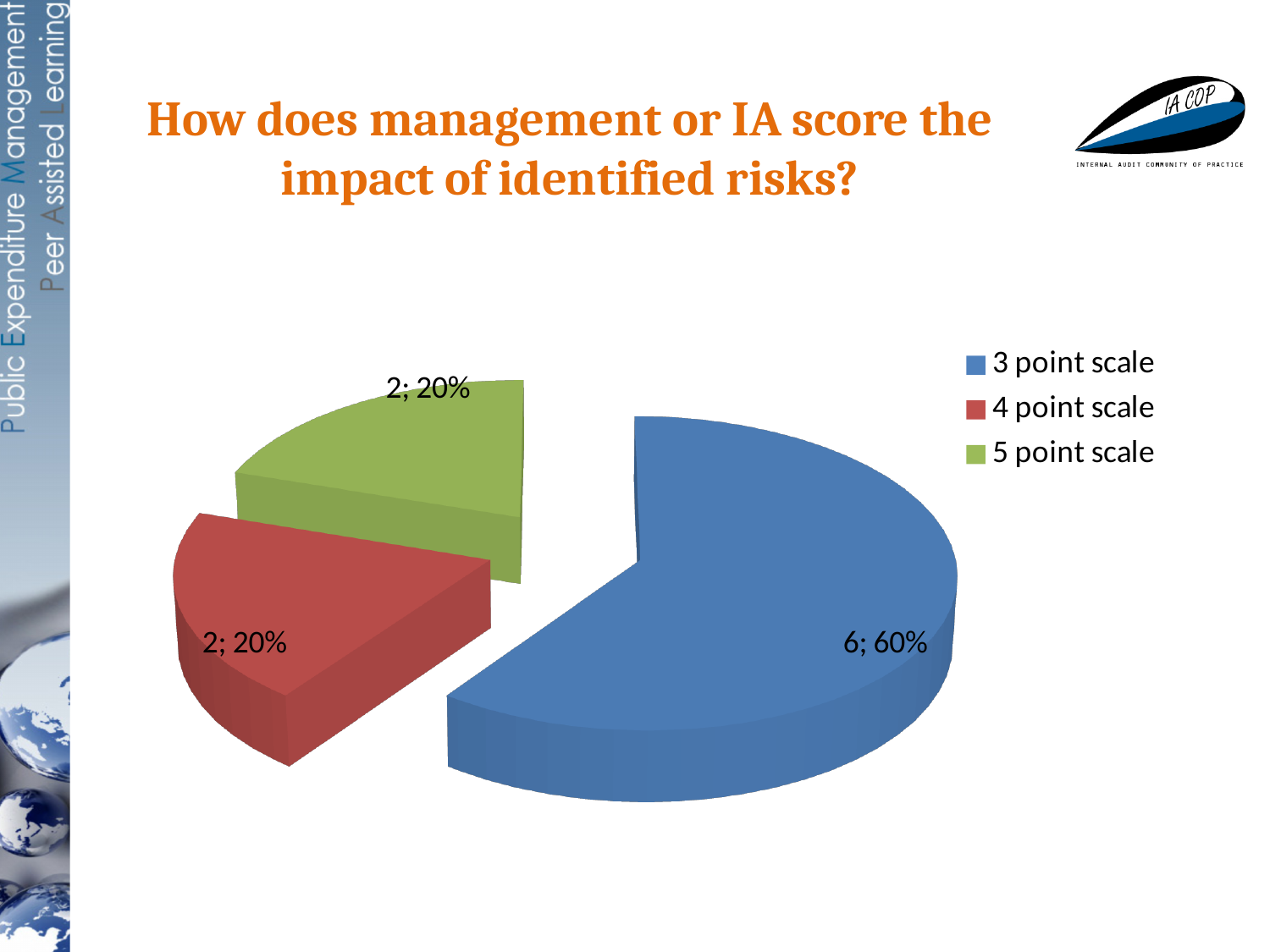
What is the difference in count between the 3 point scale and the 4 point scale? 4 Which is larger, the share for the 3 point scale or the 5 point scale? 3 point scale What is the count shown for the 3 point scale slice? 6 What is the count shown for the 4 point scale slice? 2 Which scale has the largest share of the pie? 3 point scale What is the total count across all three slices? 10 What colour is the 4 point scale slice? red How many slices does the pie chart have? 3 What kind of chart is shown on the slide? pie chart What percentage share does the 3 point scale slice have? 60% What percentage share does the 5 point scale slice have? 20% How many entries does the legend list? 3